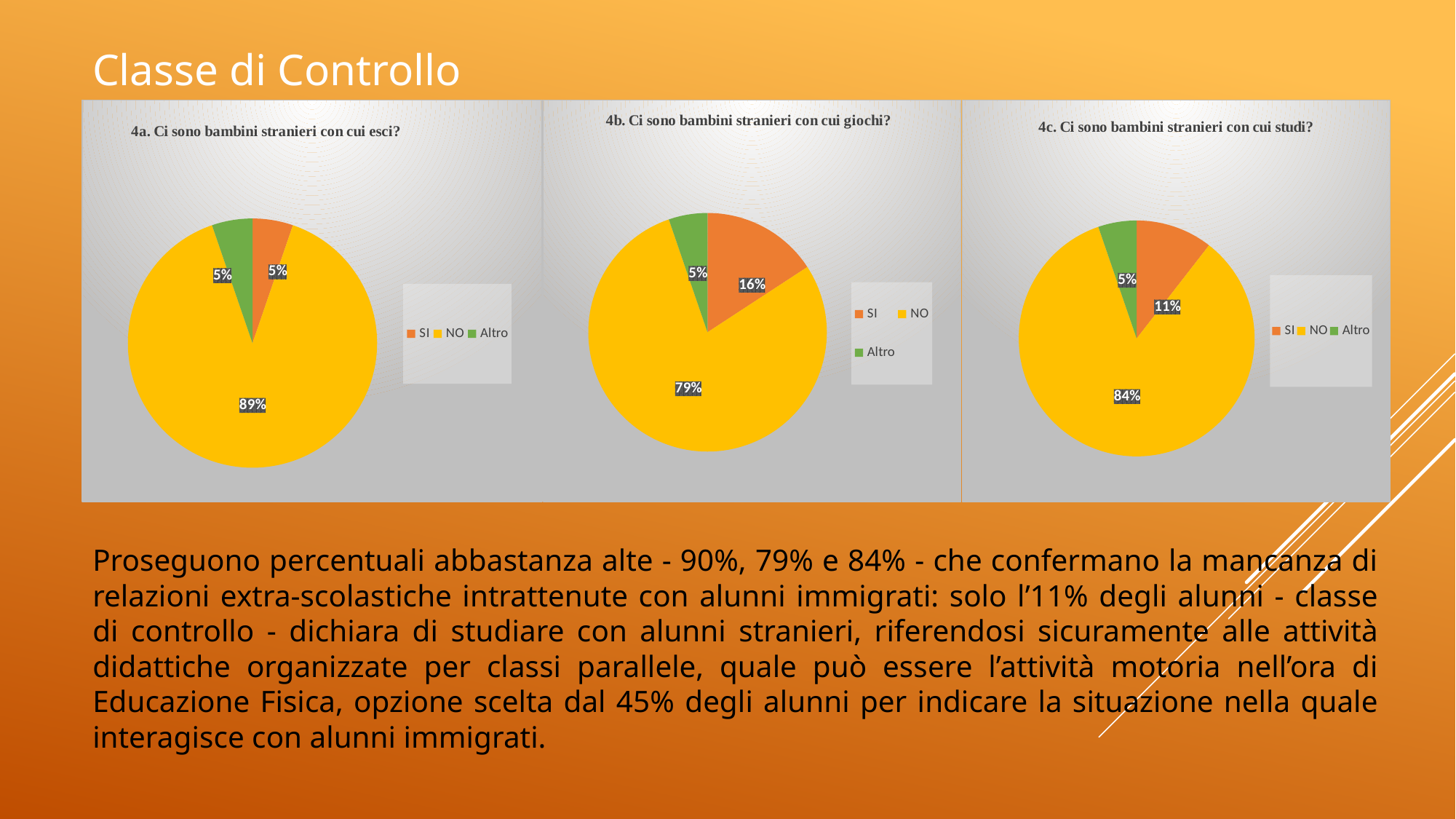
In the chart titled "4c. Ci sono bambini stranieri con cui studi?", which is larger, SI or Altro? SI What type of chart is the chart titled "4a. Ci sono bambini stranieri con cui esci?"? Pie chart How many entries does the legend of the chart titled "4c. Ci sono bambini stranieri con cui studi?" list? 3 In the chart titled "4a. Ci sono bambini stranieri con cui esci?", what percentage is shown for NO? 89% In the chart titled "4b. Ci sono bambini stranieri con cui giochi?", what is the difference between the NO and SI percentages? 63% In the chart titled "4b. Ci sono bambini stranieri con cui giochi?", which category has the largest slice? NO In the chart titled "4a. Ci sono bambini stranieri con cui esci?", what colour is the NO slice? Yellow In the chart titled "4c. Ci sono bambini stranieri con cui studi?", which category has the smallest slice? Altro How many slices does the chart titled "4b. Ci sono bambini stranieri con cui giochi?" have? 3 In the chart titled "4c. Ci sono bambini stranieri con cui studi?", what percentage is shown for Altro? 5% In the chart titled "4c. Ci sono bambini stranieri con cui studi?", what percentage is shown for SI? 11% In the chart titled "4b. Ci sono bambini stranieri con cui giochi?", what percentage is shown for SI? 16%